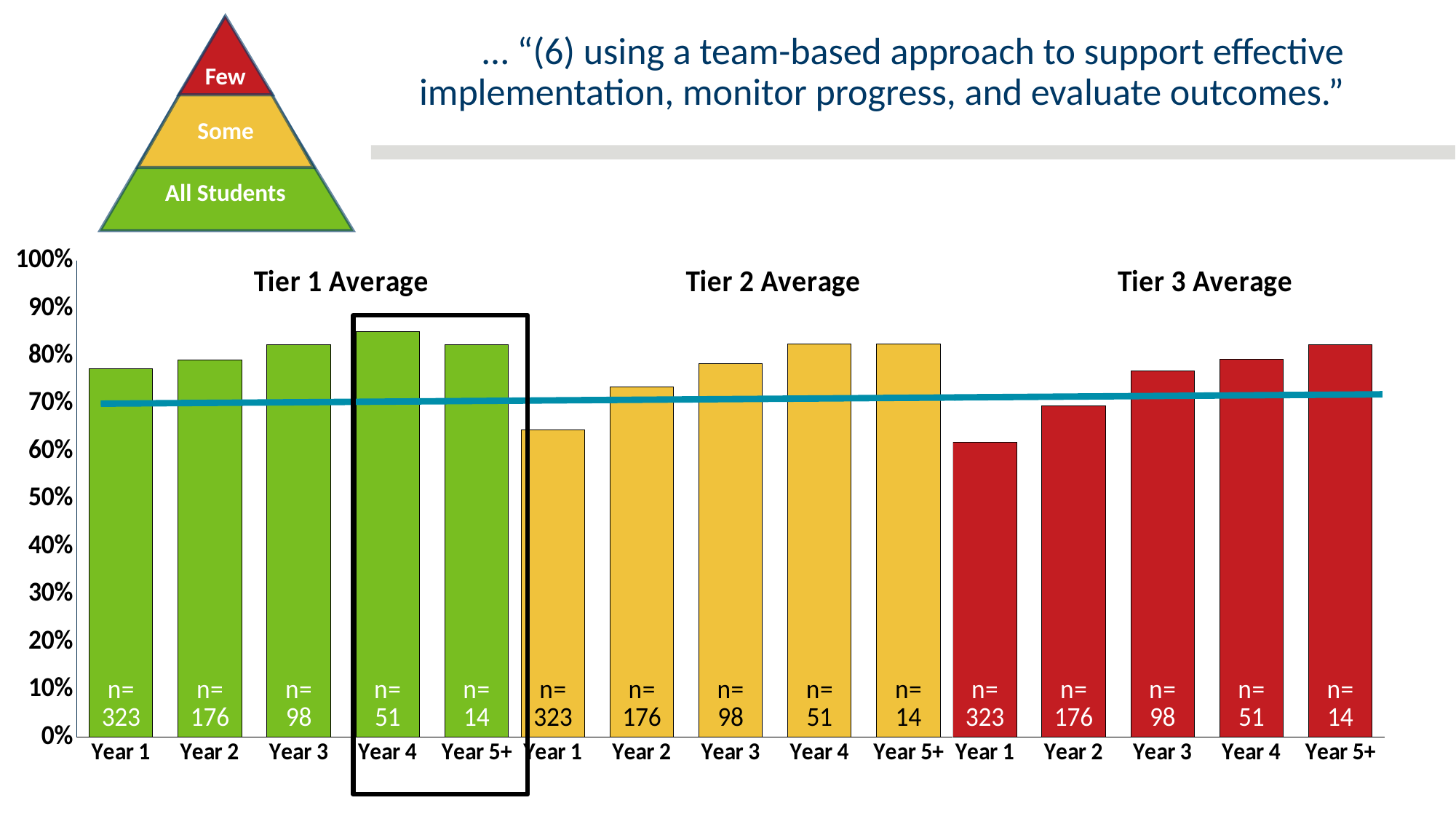
Do the bars in the Tier 3 Average group rise or fall from Year 1 to Year 5+? rise Is the value for Tier 3 Average Year 3 greater or less than 70%? greater Is the value for Tier 1 Average Year 4 greater or less than 80%? greater What is the n value printed on the Year 5+ bars? n= 14 What kind of chart is shown on the slide? bar chart Within the Tier 3 Average group, which year has the lowest bar? Year 1 Which is larger: the Year 1 bar in Tier 1 Average or the Year 1 bar in Tier 2 Average? Tier 1 Average Year 1 How many bars are plotted in the chart? 15 Is the value for Tier 2 Average Year 1 greater or less than 70%? less Within the Tier 1 Average group, which year has the highest bar? Year 4 What colour are the bars in the Tier 3 Average group? red What is the n value printed on the Tier 1 Average Year 4 bar? n= 51